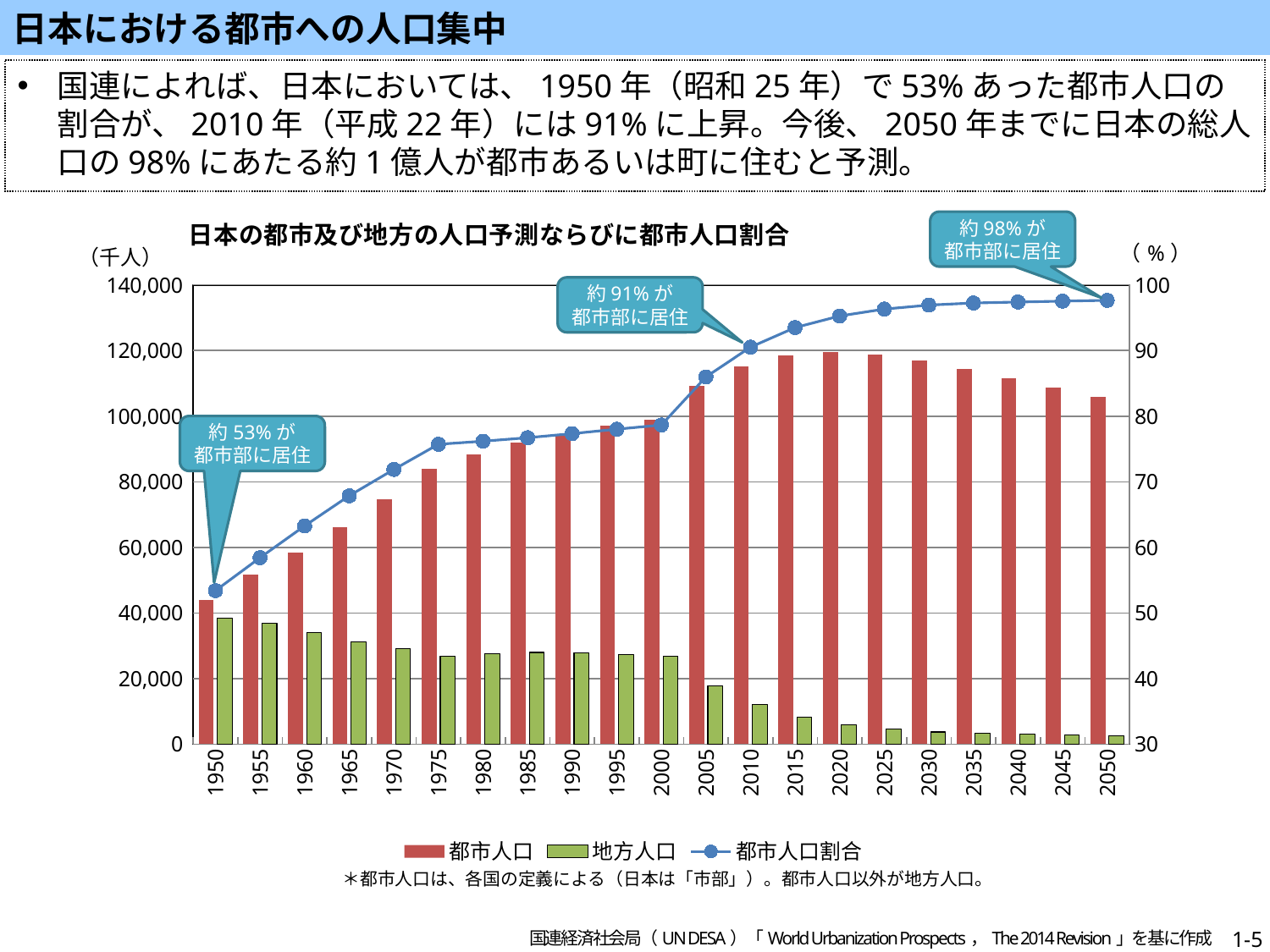
Is the 都市人口割合 value for 2050 greater or less than 90? greater Which year has the highest 地方人口 value? 1950 Does the 都市人口割合 line rise or fall from 1950 to 2050? rise Is the 都市人口 value for 1950 greater or less than 60,000? less How many series does the legend list? 3 What unit is shown on the left vertical axis? 千人 In 1950, which is larger, 都市人口 or 地方人口? 都市人口 How many years are shown on the x axis? 21 Is the 都市人口 value for 2010 greater or less than 100,000? greater What kind of chart is shown on the slide? A combined bar and line chart What is the title of the chart? 日本の都市及び地方の人口予測ならびに都市人口割合